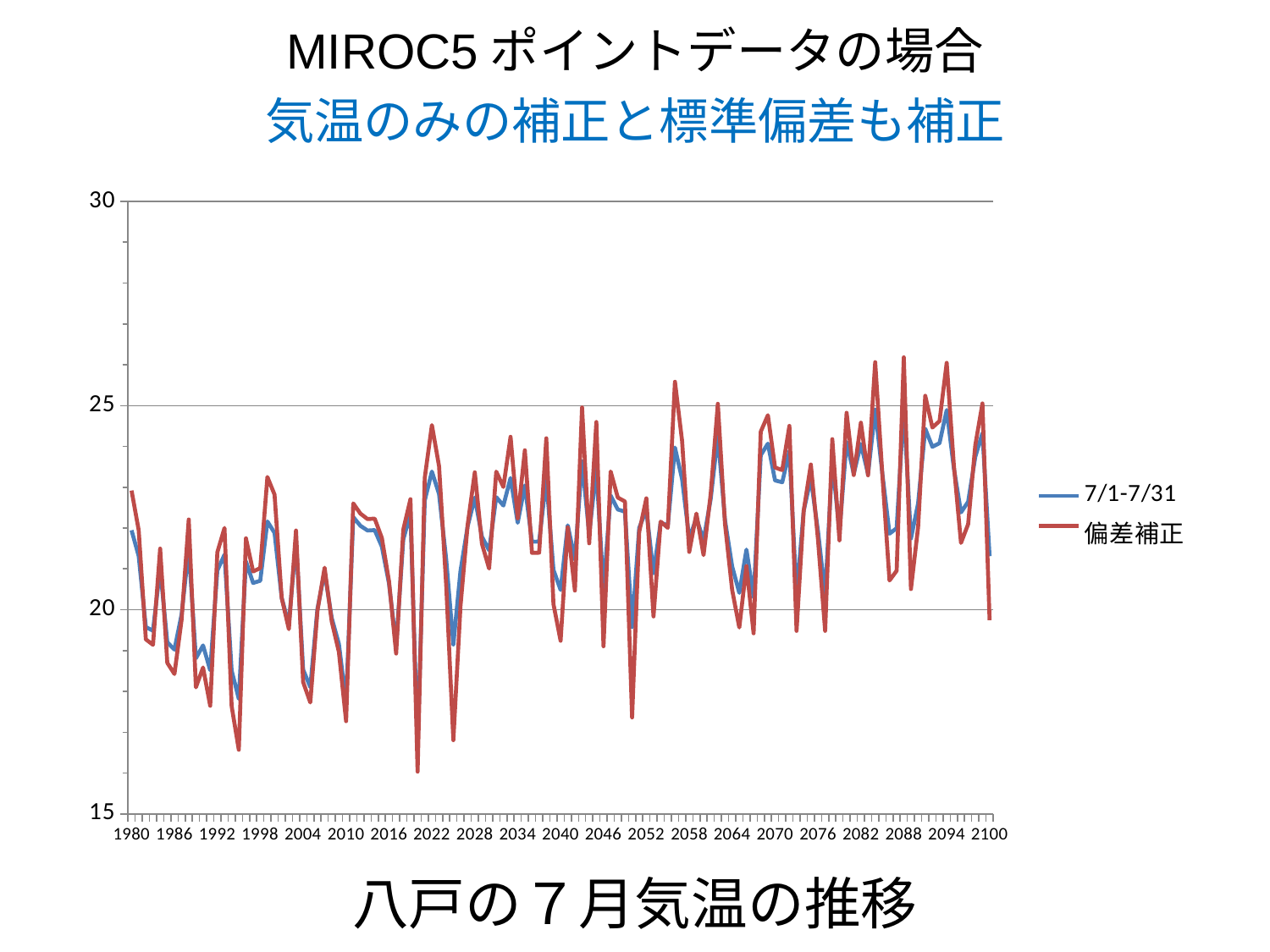
Is the value of the 7/1-7/31 series at 2100 greater or less than 20? greater What colour is the 偏差補正 line? red Is the value of the 偏差補正 series at 2100 greater or less than 20? less Is the value of the 7/1-7/31 series at 1980 greater or less than 20? greater At 2100, which series has the higher value, 7/1-7/31 or 偏差補正? 7/1-7/31 How many series does the legend list? 2 What are the two series named in the legend? 7/1-7/31 and 偏差補正 What kind of chart is shown on the slide? line chart Which series reaches the highest value anywhere on the chart? 偏差補正 Do the temperature values generally rise or fall from 1980 to 2100? rise Which series reaches the lowest value anywhere on the chart? 偏差補正